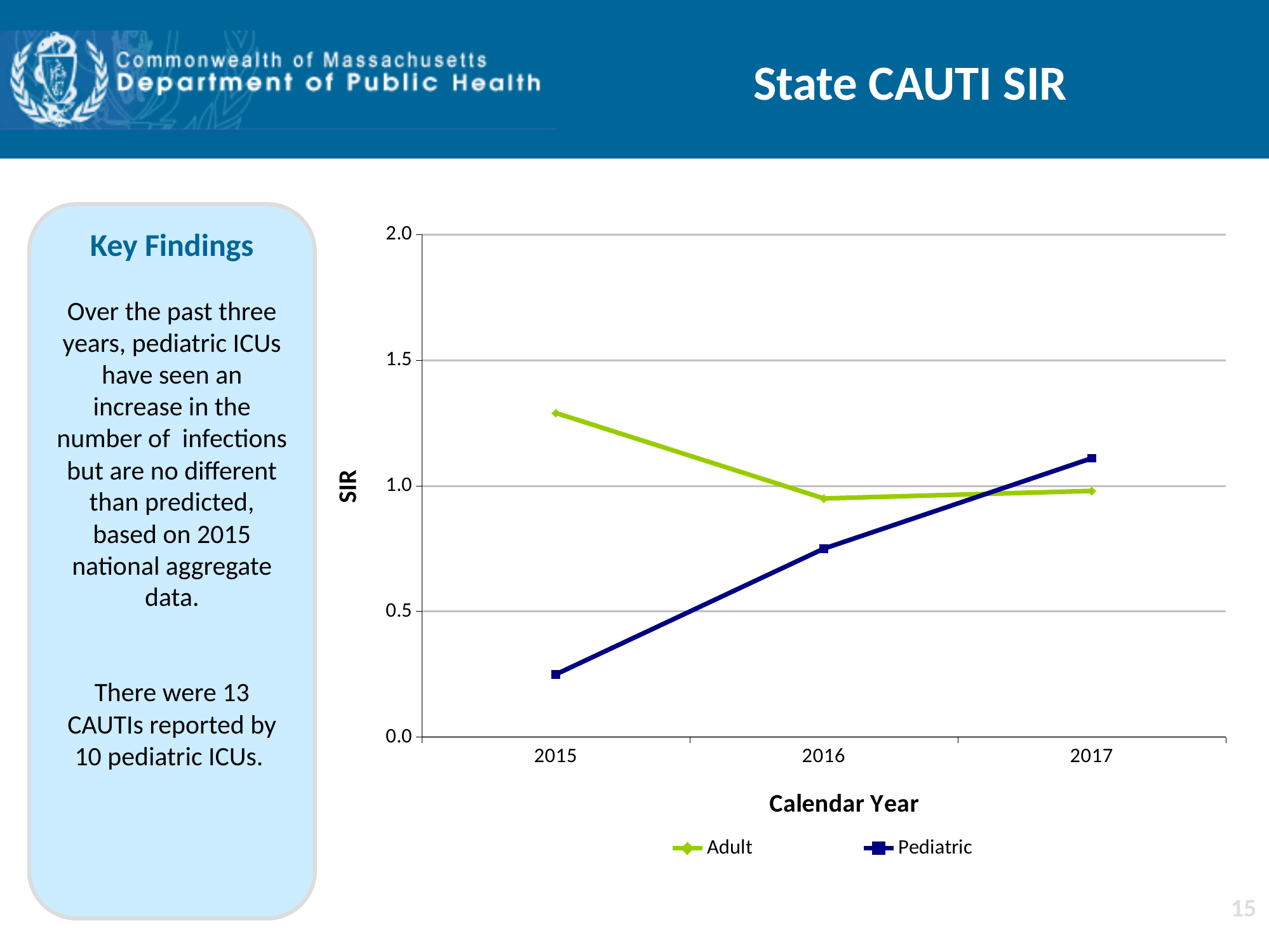
In 2017, which series has the larger SIR, Adult or Pediatric? Pediatric Is the Adult SIR for 2015 greater or less than 1.0? greater What kind of chart is shown on the slide? line chart How many calendar years are plotted on the x axis? 3 In which year is the Pediatric SIR lowest? 2015 In which year is the Pediatric SIR highest? 2017 How many series does the legend list? 2 What is the label of the x axis? Calendar Year In which year is the Adult SIR highest? 2015 Is the Pediatric SIR for 2015 greater or less than 0.5? less In 2015, which series has the larger SIR, Adult or Pediatric? Adult Does the Pediatric SIR rise or fall from 2015 to 2017? rise